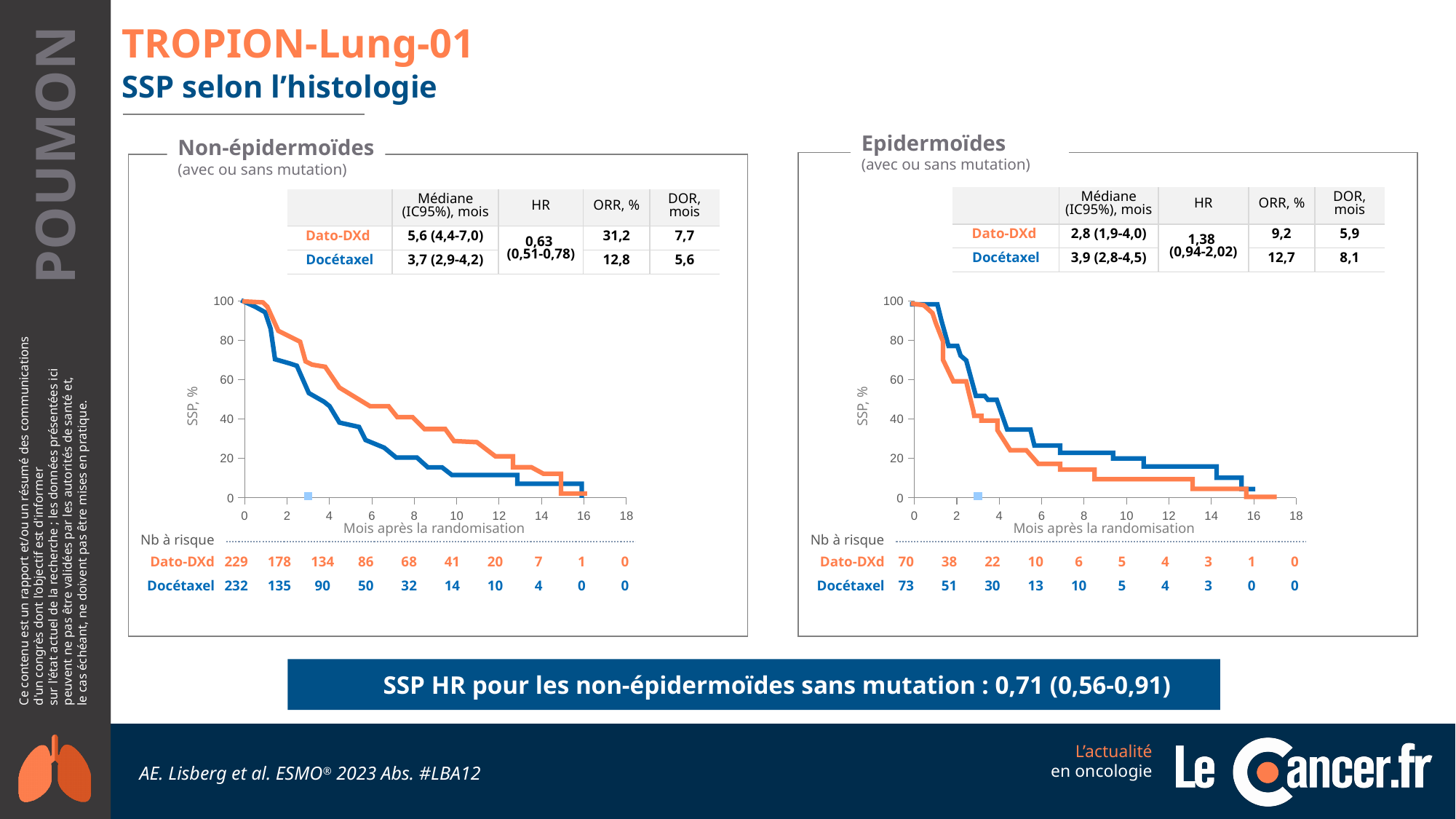
In the Epidermoïdes chart, what is the DOR in months for Dato-DXd? 5,9 In the Epidermoïdes chart, which treatment has the higher median PFS, Dato-DXd or Docétaxel? Docétaxel What kind of chart is the Non-épidermoïdes chart? Line chart In the Non-épidermoïdes chart, do the SSP curves rise or fall as months after randomisation increase? Fall In the Non-épidermoïdes chart, what is the median PFS (IC95%) in months for Dato-DXd? 5,6 (4,4-7,0) In the Epidermoïdes chart, how many Docétaxel patients are at risk at 2 months? 51 In the Non-épidermoïdes chart, how many Dato-DXd patients are at risk at 0 months? 229 How many series are plotted in the Epidermoïdes chart? 2 In the Non-épidermoïdes chart, what is the HR shown in the table? 0,63 (0,51-0,78) In the Epidermoïdes chart, what is the ORR, % for Docétaxel? 12,7 In the Non-épidermoïdes chart, what is the difference in ORR, % between Dato-DXd and Docétaxel? 18,4 In the Non-épidermoïdes chart, is the SSP value for Docétaxel at 6 months greater or less than 40? less